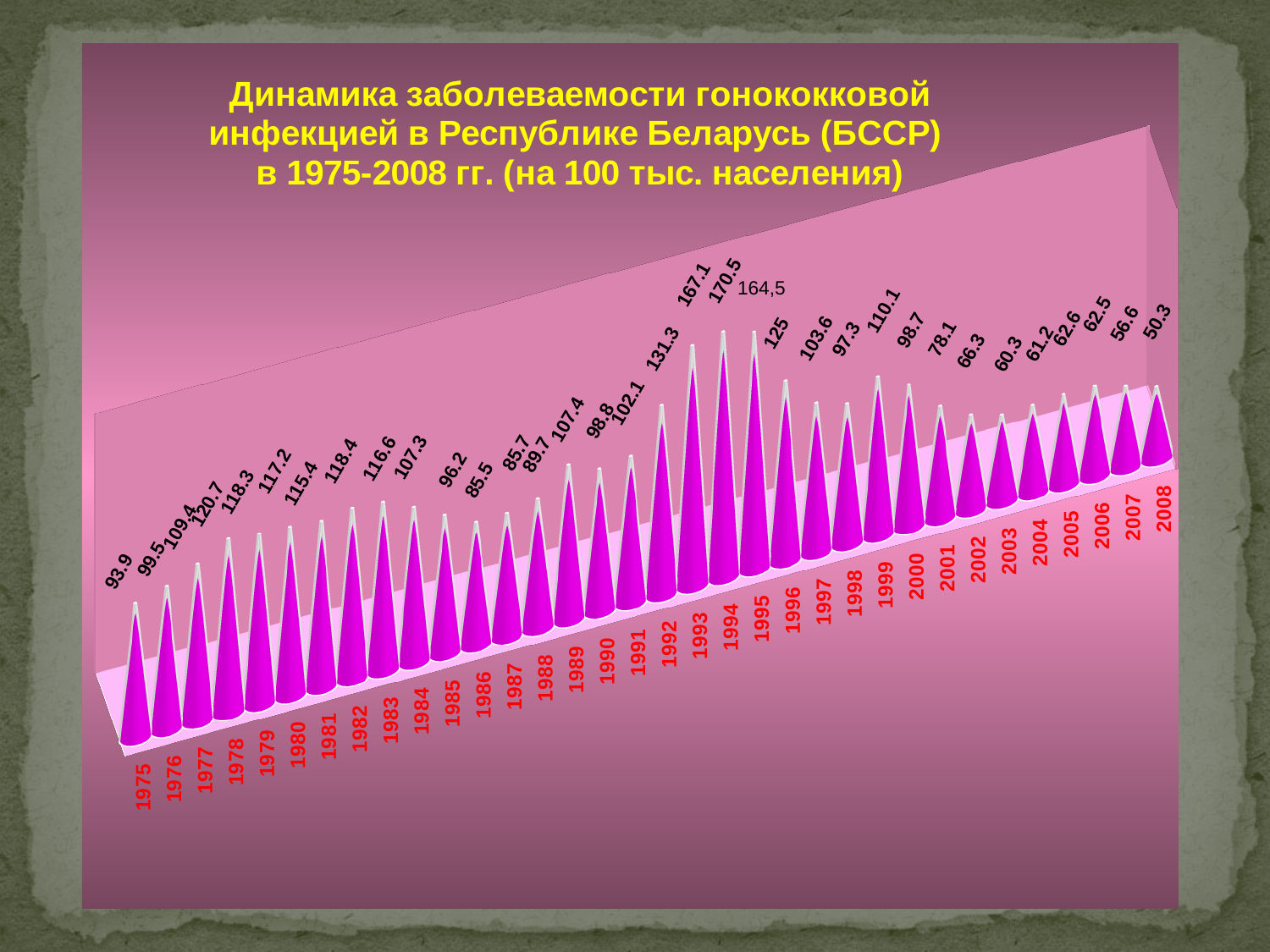
What is the difference between the values for 1975 and 2008? 43.6 What is the value for 2008? 50.3 What type of chart is shown on the slide? Bar chart What is the difference between the values for 1994 and 1993? 3.4 What is the value for 1996? 125 Which year has the lowest value? 2008 Which year has the highest value? 1994 Which year has the larger value, 1992 or 1996? 1992 What is the value for 1975? 93.9 Do the values rise or fall from 1994 to 2008? Fall What is the value for 1994? 170.5 How many years are plotted on the chart? 34